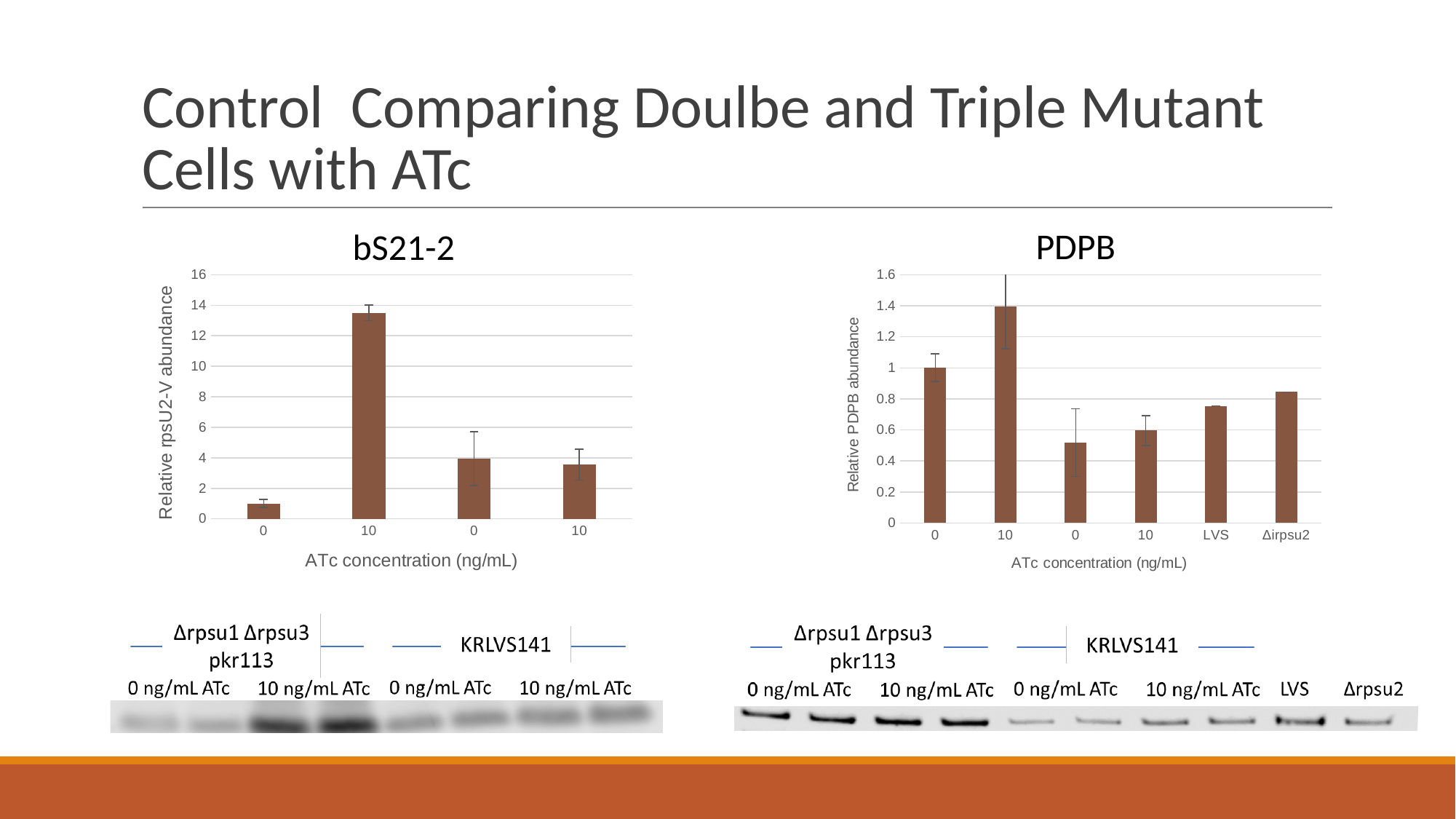
In the bS21-2 chart, which bar is the highest? the second bar (10 ng/mL) What type of chart is the bS21-2 chart? bar chart In the PDPB chart, which bar is the highest? the second bar (10 ng/mL) In the PDPB chart, is the value for LVS greater or less than 0.8? less How many bars are plotted in the PDPB chart? 6 In the PDPB chart, which is larger: the value for LVS or the value for Δirpsu2? Δirpsu2 In the bS21-2 chart, is the value of the third bar (0) greater or less than 6? less In the bS21-2 chart, is the value of the second bar (10) greater or less than 12? greater How many bars are plotted in the bS21-2 chart? 4 What is the y-axis title of the PDPB chart? Relative PDPB abundance In the bS21-2 chart, which bar is the lowest? the first bar (0 ng/mL)